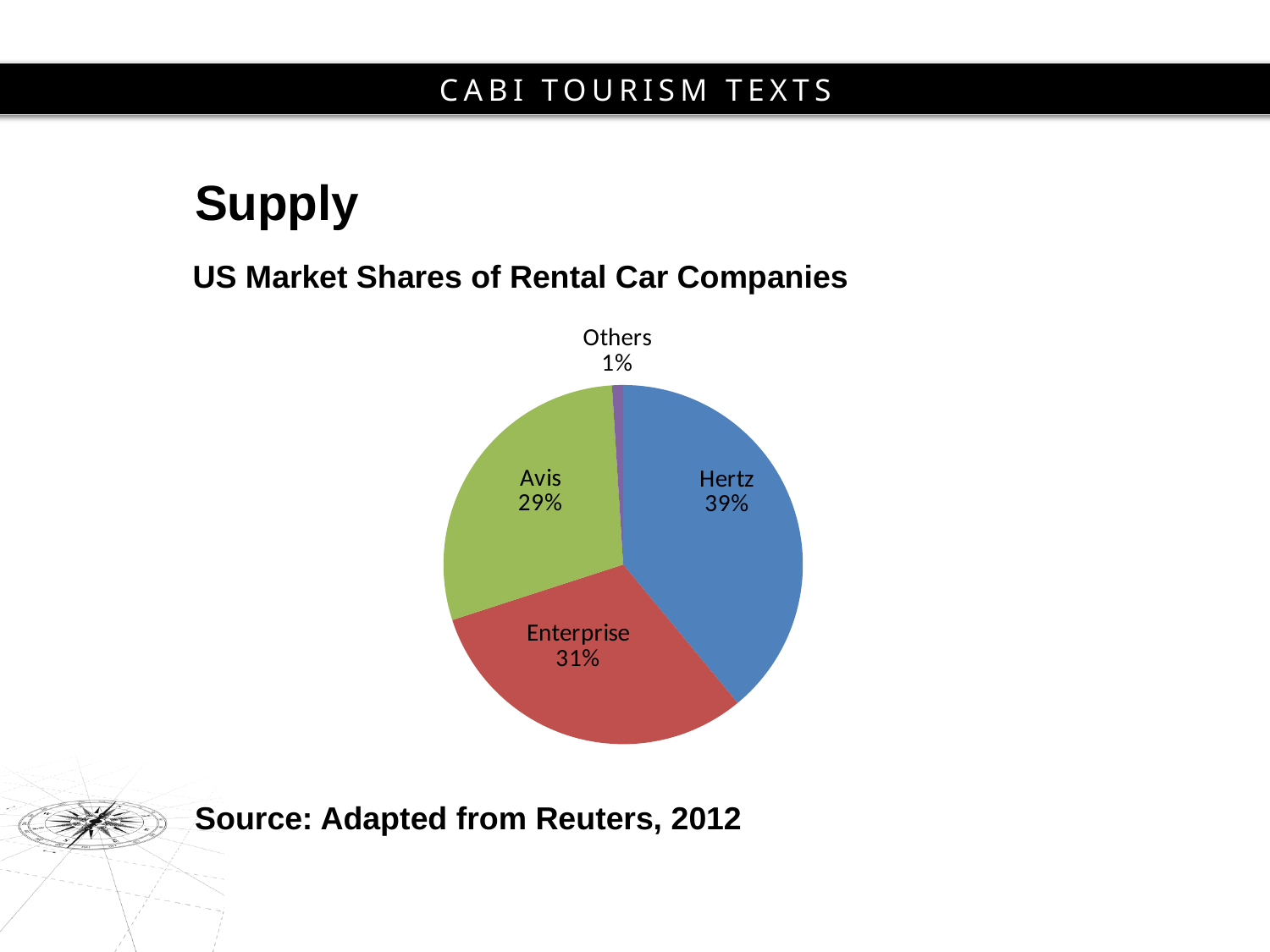
How many slices does the pie chart have? 4 What is the market share of Others? 1% What kind of chart is shown on the slide? Pie chart Which has a larger market share, Hertz or Enterprise? Hertz Which slice of the pie is the smallest? Others What is the difference in market share between Hertz and Avis? 10% What is the market share of Avis? 29% What is the market share of Hertz? 39% What is the difference in market share between Enterprise and Avis? 2% What is the market share of Enterprise? 31% Which company has the largest market share? Hertz What colour is the Enterprise slice? Red